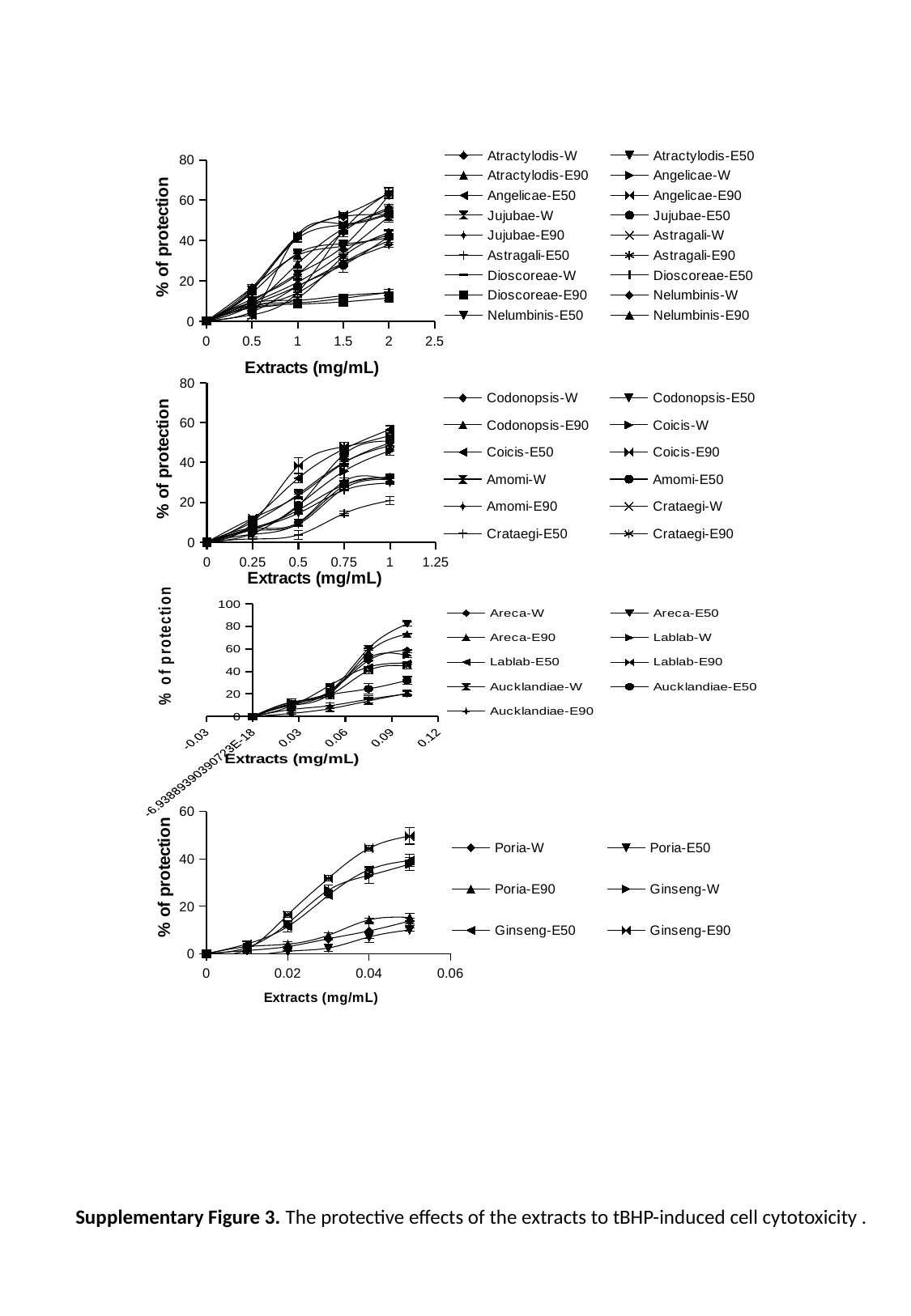
In the third chart (Areca, Lablab, Aucklandiae), is the highest value reached at the largest concentration greater or less than 60? greater How many concentration points are plotted for each series in the top chart (Atractylodis to Nelumbinis)? 5 How many series does the legend of the bottom chart (Poria and Ginseng) list? 6 In the bottom chart (Poria and Ginseng), do the values generally rise or fall as the extract concentration increases? rise How many series does the legend of the top chart (Atractylodis to Nelumbinis) list? 18 What is the y-axis label of the bottom chart (Poria and Ginseng)? % of protection How many series does the legend of the second chart (Codonopsis to Crataegi) list? 12 What kind of chart is the top chart on the slide? line chart What is the x-axis label of the second chart (Codonopsis to Crataegi)? Extracts (mg/mL) In the bottom chart, is the highest value reached at 0.05 mg/mL greater or less than 40? greater In the top chart, do the % of protection values rise or fall as the extract concentration increases along the x axis? rise